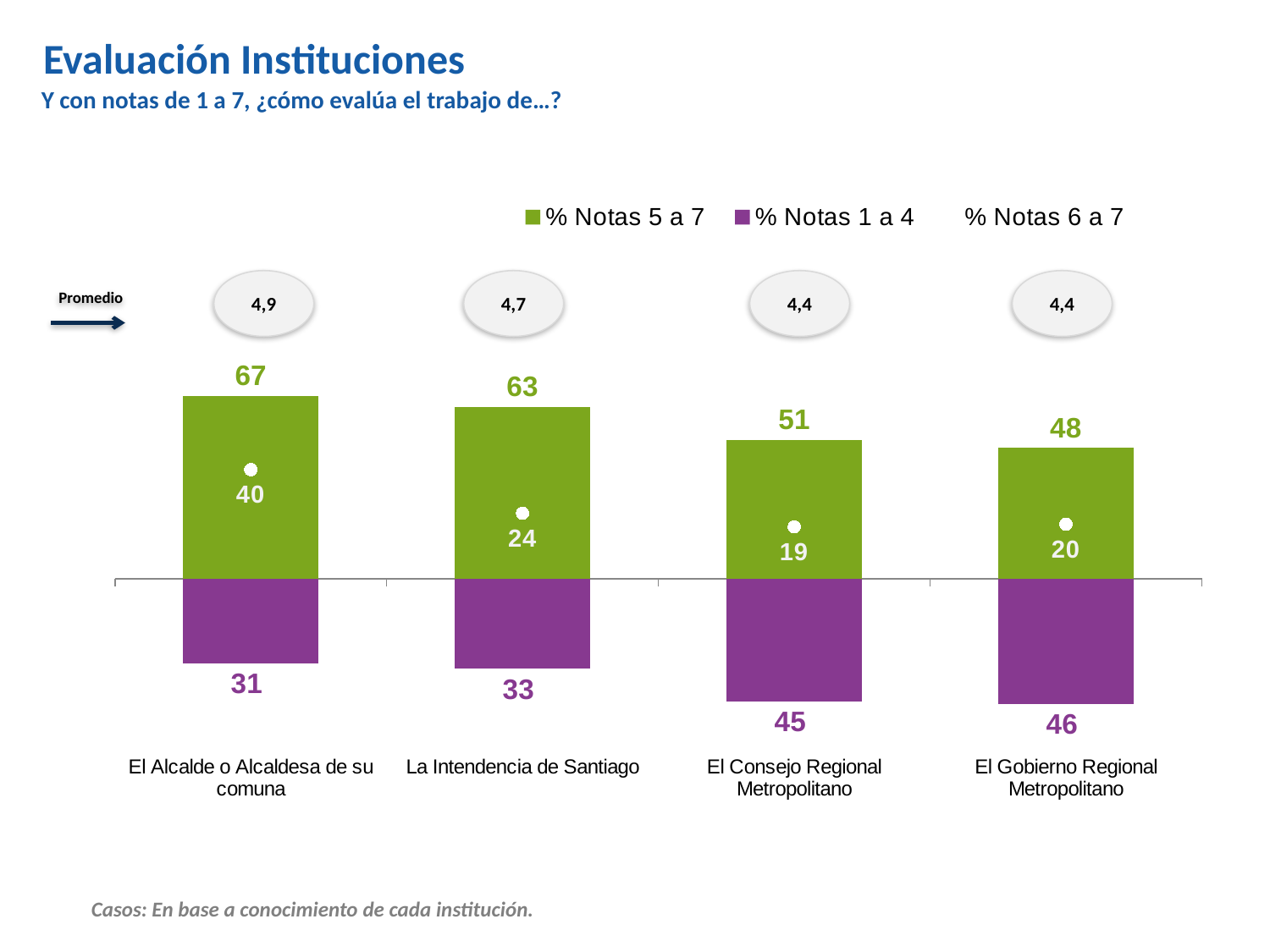
What is the value of % Notas 5 a 7 for El Alcalde o Alcaldesa de su comuna? 67 How many categories are shown on the x axis of the chart? 4 Which is larger: the % Notas 1 a 4 value for La Intendencia de Santiago or for El Gobierno Regional Metropolitano? El Gobierno Regional Metropolitano What is the Promedio shown for El Gobierno Regional Metropolitano? 4,4 What kind of chart is shown on the slide? Bar chart What is the difference between the % Notas 5 a 7 values for El Alcalde o Alcaldesa de su comuna and El Gobierno Regional Metropolitano? 19 Which category has the highest value for % Notas 5 a 7? El Alcalde o Alcaldesa de su comuna Do the % Notas 5 a 7 values rise or fall from left to right across the categories? Fall What is the value of % Notas 1 a 4 for El Consejo Regional Metropolitano? 45 Which category has the lowest value for % Notas 6 a 7? El Consejo Regional Metropolitano How many series does the chart legend list? 3 What is the value of % Notas 6 a 7 for La Intendencia de Santiago? 24